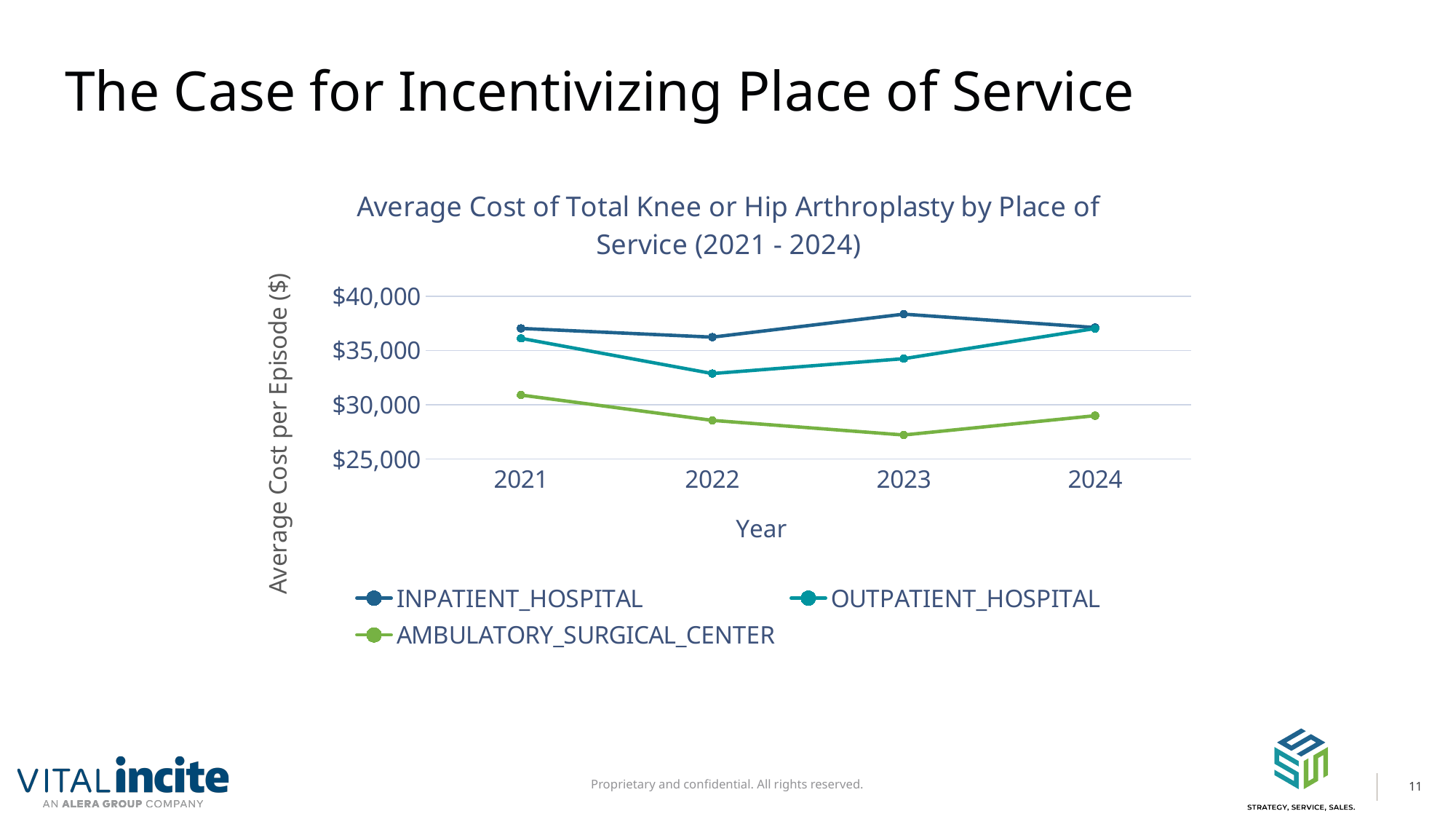
Is the value for AMBULATORY_SURGICAL_CENTER in 2022 greater or less than $30,000? less In which year is the OUTPATIENT_HOSPITAL value lowest? 2022 Is the value for INPATIENT_HOSPITAL in 2023 greater or less than $40,000? less Is the value for INPATIENT_HOSPITAL in 2021 greater or less than $35,000? greater What kind of chart is shown on the slide? Line chart How many years are plotted along the x axis? 4 Does the AMBULATORY_SURGICAL_CENTER line rise or fall from 2021 to 2023? fall In 2022, which is larger: INPATIENT_HOSPITAL or OUTPATIENT_HOSPITAL? INPATIENT_HOSPITAL How many series does the legend list? 3 In which year is the AMBULATORY_SURGICAL_CENTER value lowest? 2023 In which year is the INPATIENT_HOSPITAL value highest? 2023